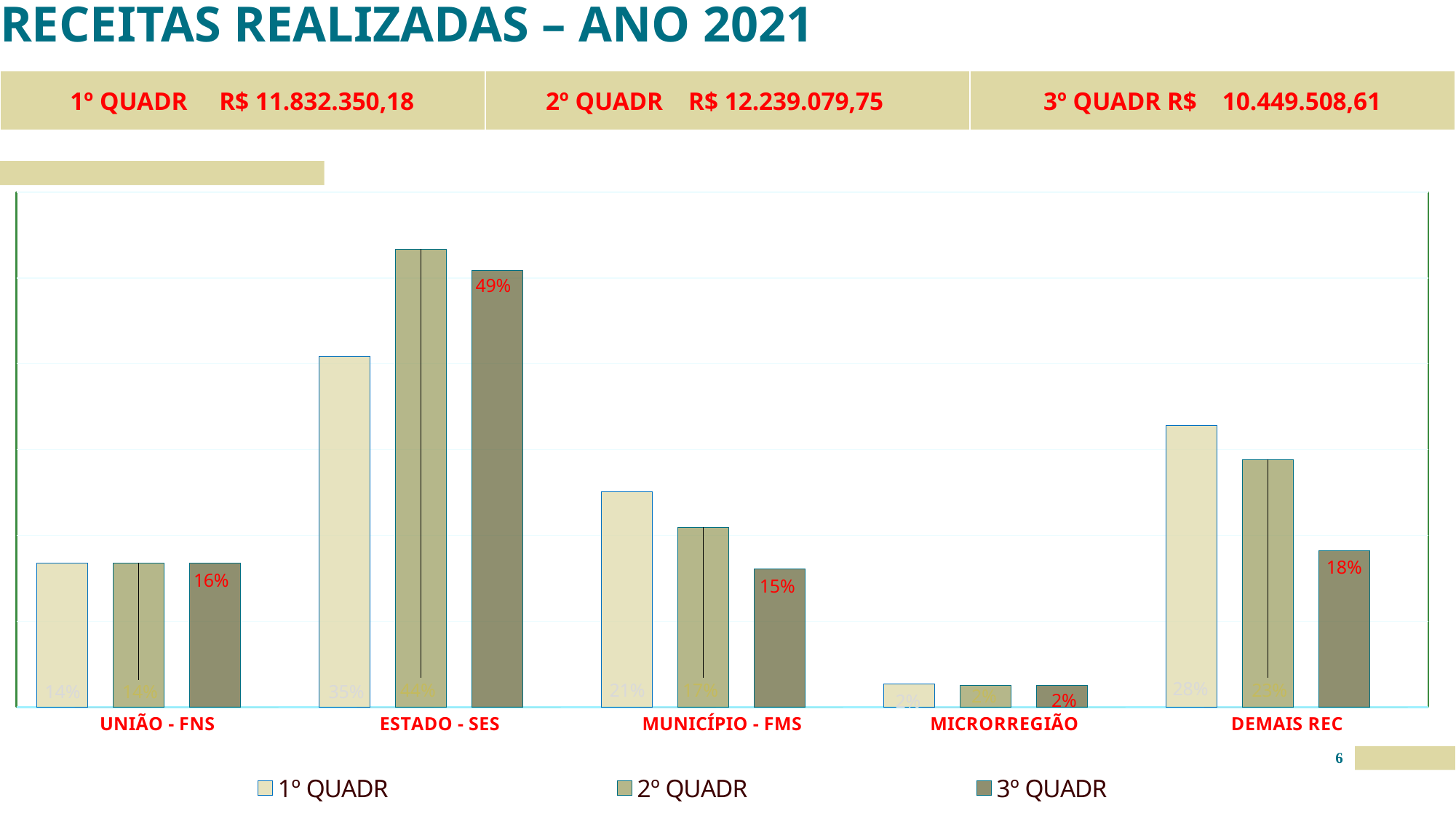
What is the 3º QUADR value for DEMAIS REC? 18% What is the 1º QUADR value for ESTADO - SES? 35% How many categories are shown on the x axis of the chart? 5 What is the 3º QUADR value for MUNICÍPIO - FMS? 15% What is the 3º QUADR value for UNIÃO - FNS? 16% Which category has the highest 3º QUADR value? ESTADO - SES For DEMAIS REC, which is larger: the 1º QUADR value or the 3º QUADR value? 1º QUADR Which category has the lowest 3º QUADR value? MICRORREGIÃO What is the 3º QUADR value for ESTADO - SES? 49% What is the difference between the 3º QUADR values for ESTADO - SES and DEMAIS REC? 31% What kind of chart is shown on the slide? bar chart How many series does the chart legend list? 3